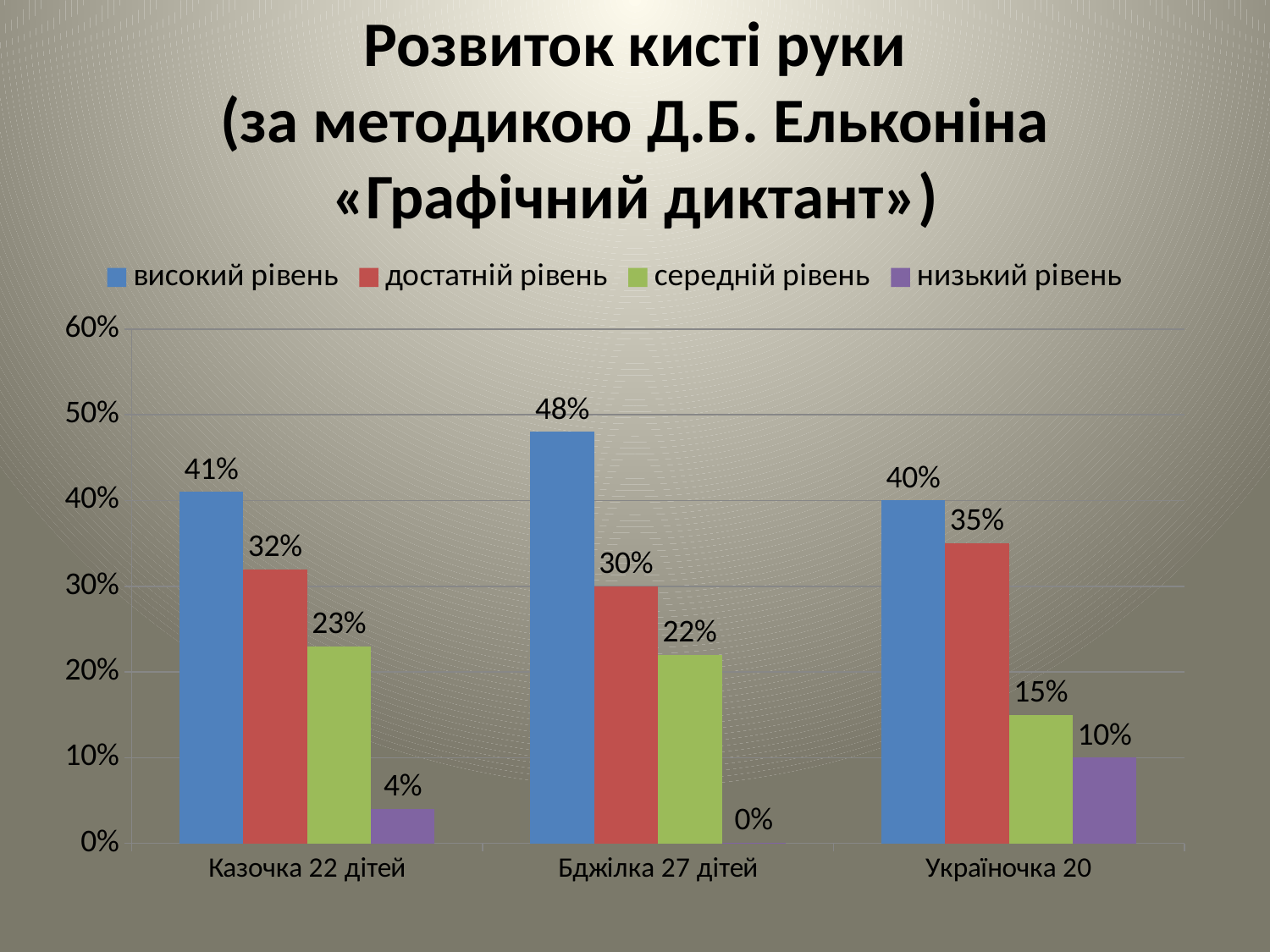
Which group has the highest value for високий рівень? Бджілка 27 дітей What is the difference between достатній рівень in Україночка 20 and достатній рівень in Бджілка 27 дітей? 5% Which is larger: середній рівень in Казочка 22 дітей or середній рівень in Україночка 20? Казочка 22 дітей Is the value for високий рівень in Казочка 22 дітей greater or less than 30%? greater What is the value for низький рівень in the Україночка 20 group? 10% Which colour represents низький рівень in the legend? purple How many series does the legend list? 4 What kind of chart is shown on the slide? bar chart What is the value for високий рівень in the Бджілка 27 дітей group? 48% What is the value for середній рівень in the Казочка 22 дітей group? 23% How many groups are shown on the x axis? 3 Which group has the lowest value for низький рівень? Бджілка 27 дітей